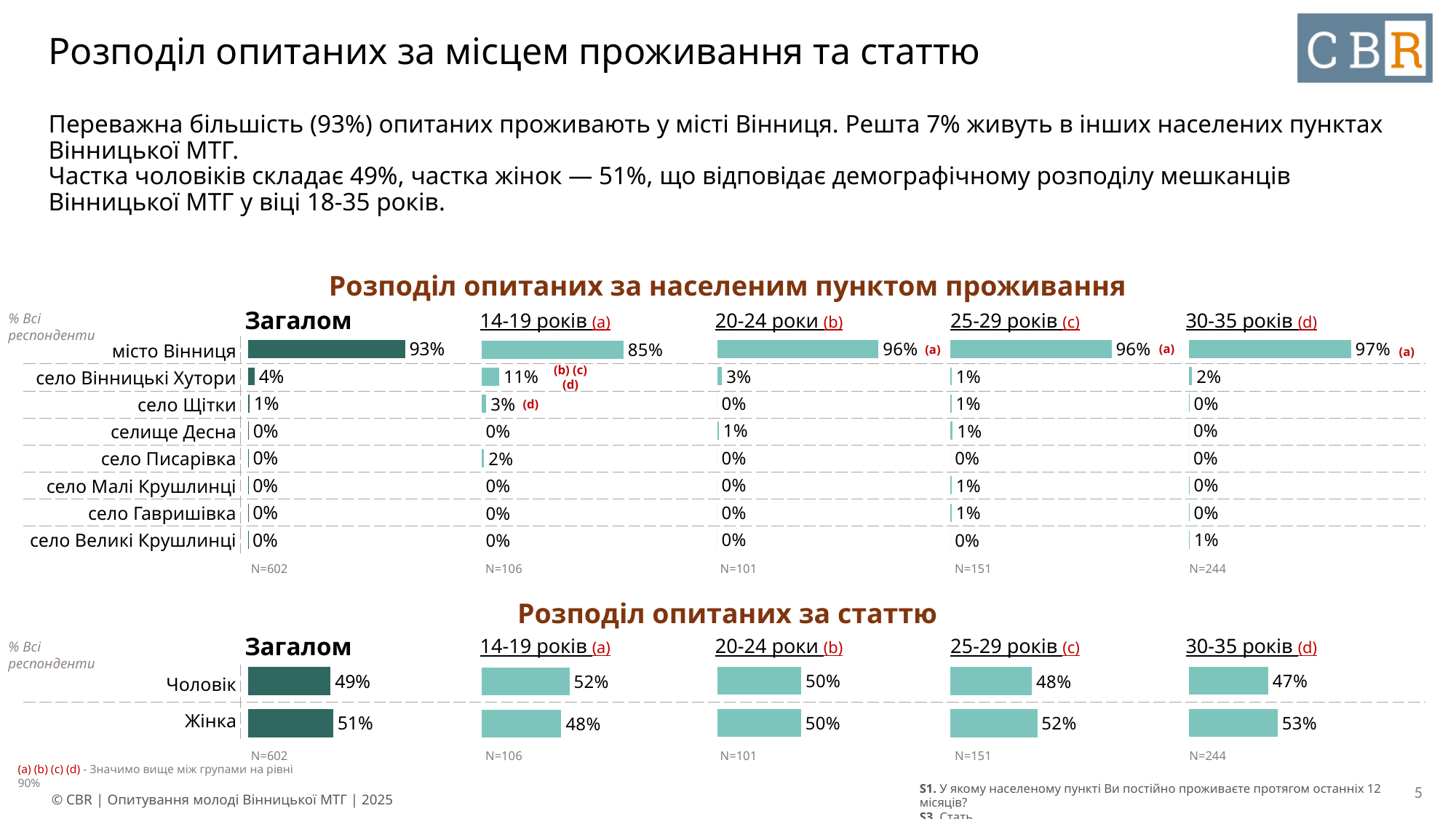
In the chart 'Розподіл опитаних за населеним пунктом проживання', which age group has the larger value for село Вінницькі Хутори: 14-19 років or 20-24 роки? 14-19 років How many settlement categories are listed in the chart 'Розподіл опитаних за населеним пунктом проживання'? 8 In the chart 'Розподіл опитаних за статтю', what is the value for Жінка in the 30-35 років column? 53% In the chart 'Розподіл опитаних за населеним пунктом проживання', what is the value for місто Вінниця in the 30-35 років column? 97% In the chart 'Розподіл опитаних за статтю', what is the value for Чоловік in the Загалом column? 49% In the chart 'Розподіл опитаних за населеним пунктом проживання', what is the difference between the місто Вінниця values for 30-35 років and 14-19 років? 12 percentage points In the chart 'Розподіл опитаних за статтю', which is larger in the 14-19 років column: Чоловік or Жінка? Чоловік In the chart 'Розподіл опитаних за населеним пунктом проживання', what is the value for село Вінницькі Хутори in the 14-19 років column? 11% In the chart 'Розподіл опитаних за населеним пунктом проживання', what is the value for місто Вінниця in the Загалом column? 93% In the chart 'Розподіл опитаних за населеним пунктом проживання', which settlement has the highest value in the Загалом column? місто Вінниця What type of chart is used in 'Розподіл опитаних за статтю'? Bar chart In the chart 'Розподіл опитаних за статтю', what is the difference between Жінка and Чоловік in the Загалом column? 2 percentage points